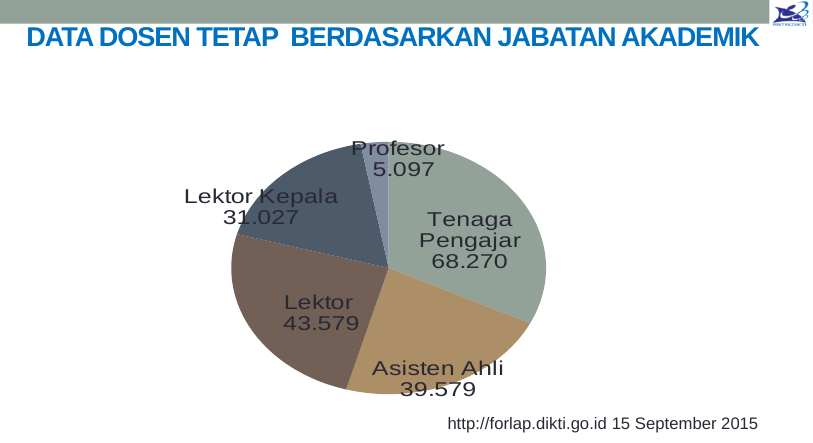
What is the value for Lektor Kepala? 31.027 What is the difference between the values for Tenaga Pengajar and Profesor? 63.173 Which is larger, the value for Lektor or the value for Lektor Kepala? Lektor How many categories are shown in the pie chart? 5 What is the title of the slide containing the chart? DATA DOSEN TETAP BERDASARKAN JABATAN AKADEMIK What kind of chart is shown on the slide? pie chart What is the difference between the values for Lektor and Asisten Ahli? 4.000 What is the value for Asisten Ahli? 39.579 Which category has the smallest slice of the pie? Profesor What is the value for Profesor? 5.097 What is the value for Tenaga Pengajar? 68.270 Which category has the largest slice of the pie? Tenaga Pengajar